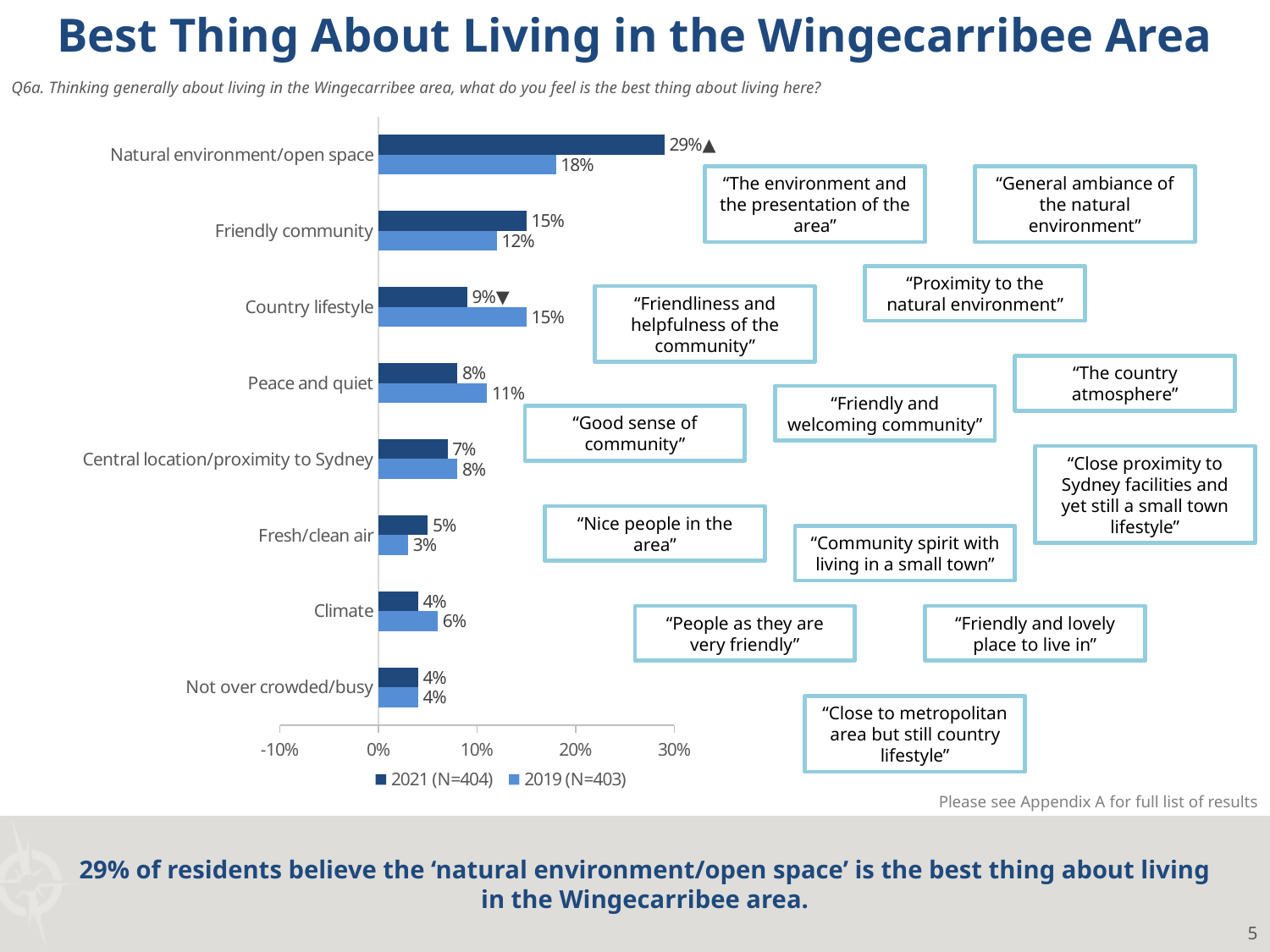
How many series does the legend list? 2 What was the 2019 value for 'Country lifestyle'? 15% What was the 2019 value for 'Climate'? 6% What is the difference between the 2021 and 2019 values for 'Natural environment/open space'? 11% For 'Country lifestyle', which year has the larger value, 2021 or 2019? 2019 Which category has the lowest value in the 2019 series? Fresh/clean air What is the sample size (N) for the 2021 series shown in the legend? 404 What was the 2021 value for 'Peace and quiet'? 8% What kind of chart is shown on the slide? Bar chart How many categories are shown on the chart? 8 Which category has the highest value in the 2021 series? Natural environment/open space What percentage of residents in 2021 said 'Natural environment/open space' was the best thing about living in the area? 29%